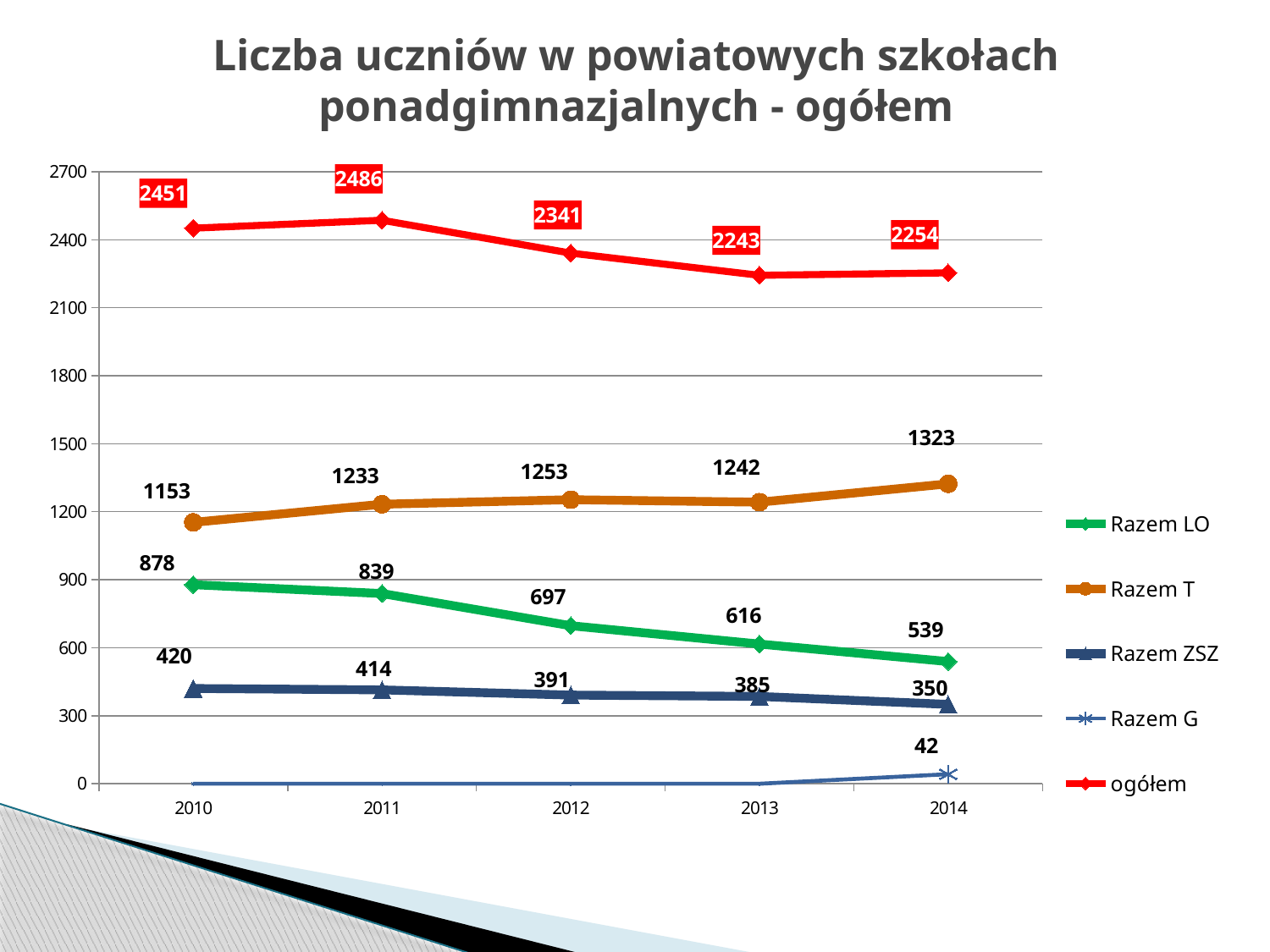
In which year is the Razem LO series lowest? 2014 What is the value for ogółem in 2011? 2486 How many years are shown on the x axis? 5 What is the value for Razem ZSZ in 2013? 385 What is the value for Razem LO in 2012? 697 What is the difference between the Razem LO values in 2010 and 2014? 339 What is the value for Razem T in 2014? 1323 How many series does the legend list? 5 In which year is the ogółem series highest? 2011 What kind of chart is this? line chart Does the Razem LO series rise or fall from 2010 to 2014? fall Which is larger, Razem T in 2012 or Razem T in 2013? Razem T in 2012